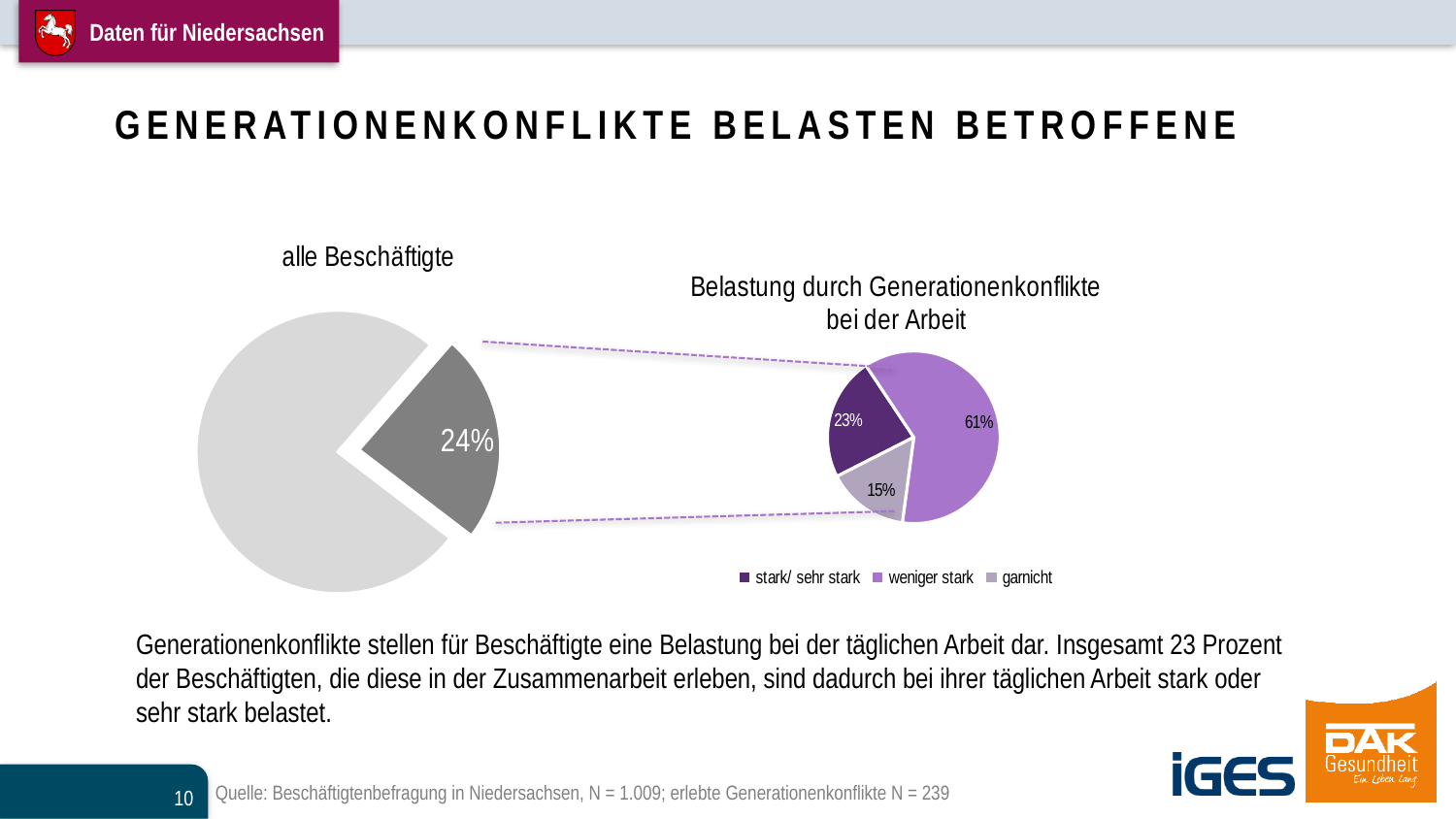
In the 'Belastung durch Generationenkonflikte bei der Arbeit' chart, what is the value for 'stark/ sehr stark'? 23% What kind of chart is the 'alle Beschäftigte' chart on the left? pie chart In the 'Belastung durch Generationenkonflikte bei der Arbeit' chart, which category has the smallest share? garnicht In the 'alle Beschäftigte' chart on the left, what percentage is shown on the highlighted dark grey slice? 24% What is the title of the pie chart on the right? Belastung durch Generationenkonflikte bei der Arbeit In the 'Belastung durch Generationenkonflikte bei der Arbeit' chart, what is the value for 'garnicht'? 15% How many pie charts are shown on the slide? 2 In the 'Belastung durch Generationenkonflikte bei der Arbeit' chart, which category has the largest share? weniger stark In the 'Belastung durch Generationenkonflikte bei der Arbeit' chart, which is larger: 'stark/ sehr stark' or 'garnicht'? stark/ sehr stark In the 'Belastung durch Generationenkonflikte bei der Arbeit' chart, what is the difference between 'weniger stark' and 'stark/ sehr stark'? 38% How many categories does the legend of the 'Belastung durch Generationenkonflikte bei der Arbeit' chart list? 3 In the 'Belastung durch Generationenkonflikte bei der Arbeit' chart, what is the value for 'weniger stark'? 61%